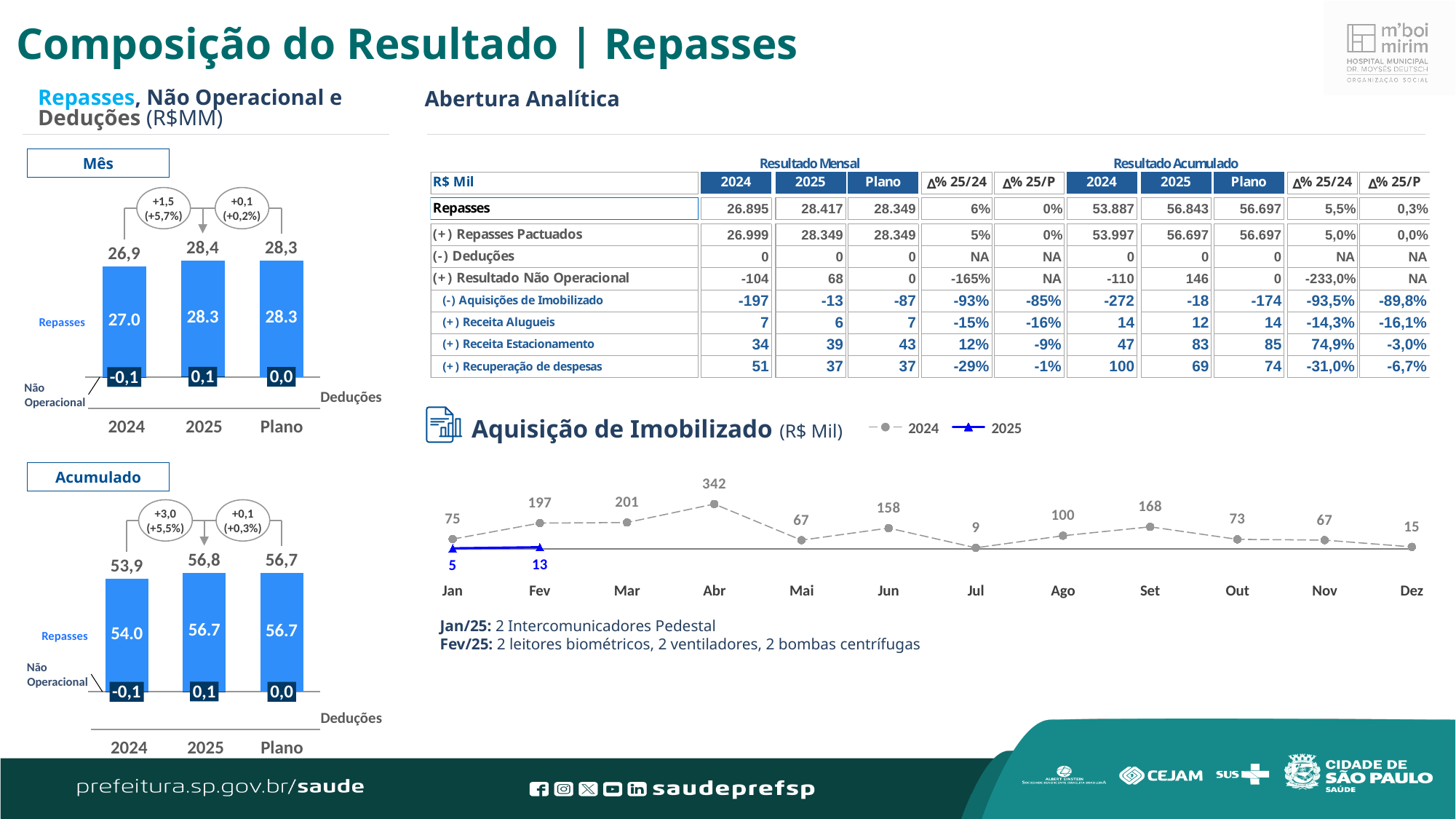
How many months are shown on the x axis of the 'Aquisição de Imobilizado' chart? 12 In the 'Acumulado' bar chart on the left, what is the Repasses value for 2024? 54.0 In the 'Aquisição de Imobilizado' line chart, what is the 2025 value for Fev? 13 In the 'Aquisição de Imobilizado' line chart, what is the 2024 value for Abr? 342 In the 'Aquisição de Imobilizado' chart, what is the difference between the 2024 values for Abr and Mar? 141 In the 'Mês' bar chart on the left, what is the total shown above the 2024 bar? 26,9 In the 'Mês' bar chart on the left, what is the Repasses value for 2025? 28.3 What kind of chart is the 'Aquisição de Imobilizado' chart? Line chart In the 'Acumulado' chart on the left, which is larger, the Repasses value for 2024 or for 2025? 2025 How many series does the legend of the 'Aquisição de Imobilizado' chart list? 2 In the 'Aquisição de Imobilizado' line chart, which month has the lowest 2024 value? Jul In the 'Aquisição de Imobilizado' line chart, which month has the highest 2024 value? Abr